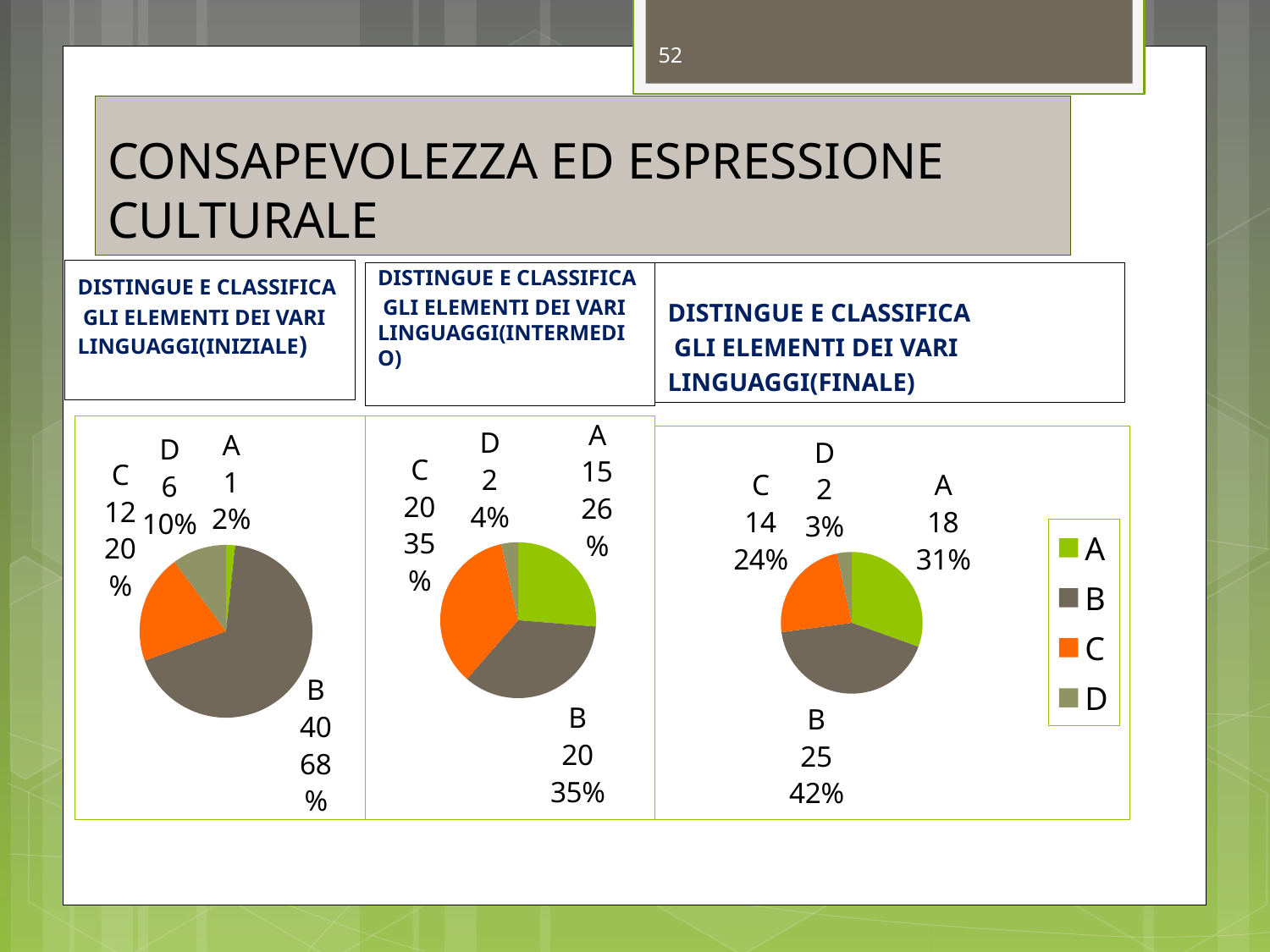
In the right pie chart (FINALE), what is the value for category C? 14 In the right pie chart (FINALE), what share of the pie does category B represent? 42% In the middle pie chart (INTERMEDIO), what is the value for category A? 15 In the right pie chart (FINALE), which category has the largest slice? B What kind of chart is used in the left panel (INIZIALE)? Pie chart In the right pie chart (FINALE), which is larger, the value for A or the value for C? A How many categories does the legend next to the right pie chart (FINALE) list? 4 In the left pie chart (INIZIALE), what share of the pie does category C represent? 20% In the left pie chart (INIZIALE), which category has the smallest slice? A In the left pie chart (INIZIALE), what is the value for category B? 40 In the middle pie chart (INTERMEDIO), what is the difference between the values for B and A? 5 In the middle pie chart (INTERMEDIO), what share of the pie does category D represent? 4%